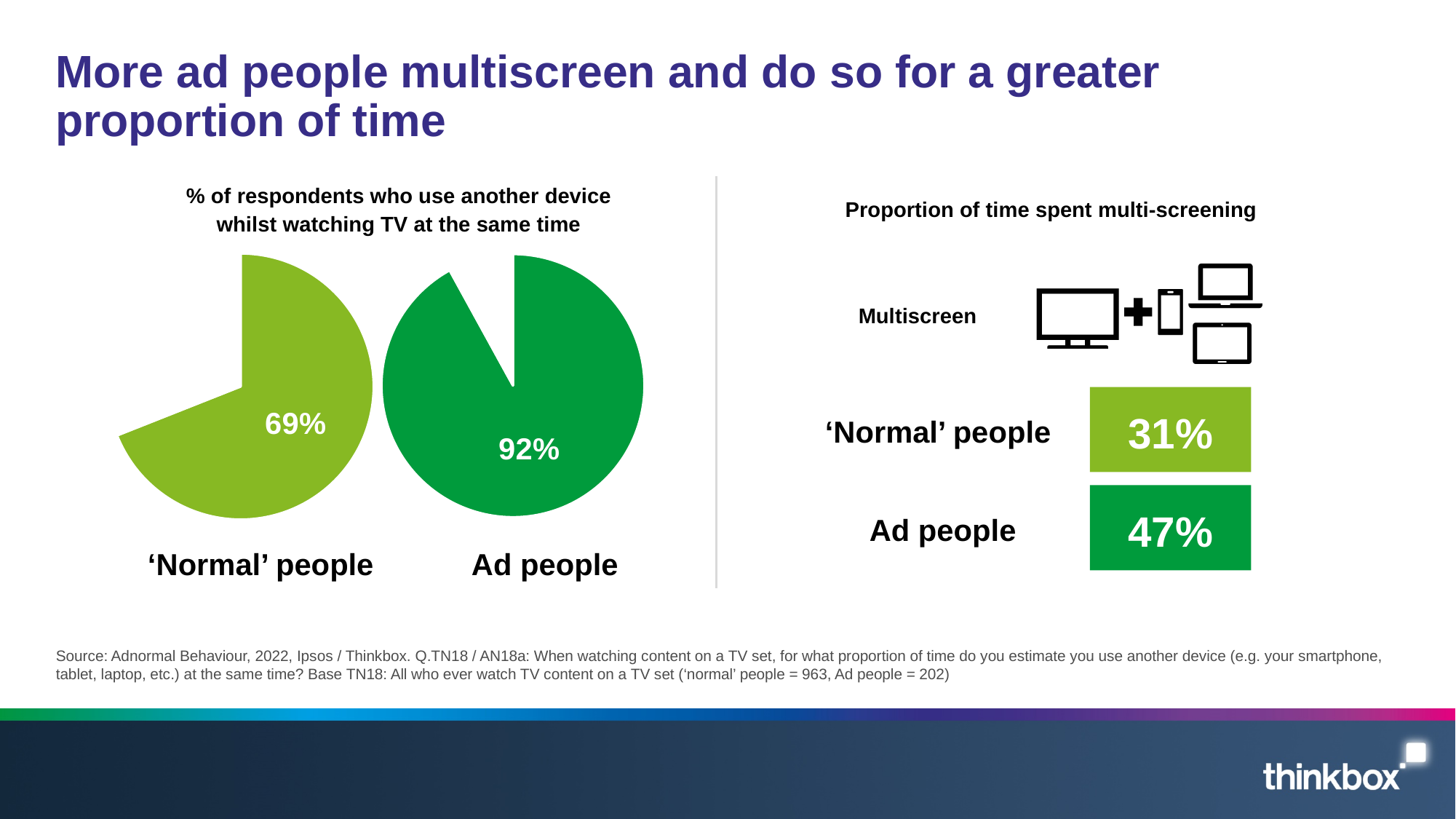
In the 'Proportion of time spent multi-screening' section, what is the difference in percentage points between Ad people and 'Normal' people? 16 percentage points In the chart titled '% of respondents who use another device whilst watching TV at the same time', which group has the higher percentage? Ad people In the chart titled '% of respondents who use another device whilst watching TV at the same time', what is the difference in percentage points between Ad people and 'Normal' people? 23 percentage points In the chart titled '% of respondents who use another device whilst watching TV at the same time', which group has the lower percentage? 'Normal' people In the chart titled '% of respondents who use another device whilst watching TV at the same time', what percentage is shown for Ad people? 92% In the 'Proportion of time spent multi-screening' section, which group spends a greater proportion of time multi-screening? Ad people In the 'Proportion of time spent multi-screening' section, what value is shown for 'Normal' people? 31% What is the title of the chart on the left side of the slide? % of respondents who use another device whilst watching TV at the same time In the chart titled '% of respondents who use another device whilst watching TV at the same time', what percentage is shown for 'Normal' people? 69% In the 'Proportion of time spent multi-screening' section, what value is shown for Ad people? 47% How many pie charts are shown on the left side of the slide? 2 What type of chart is used on the left side of the slide to show the % of respondents who use another device whilst watching TV? Pie chart